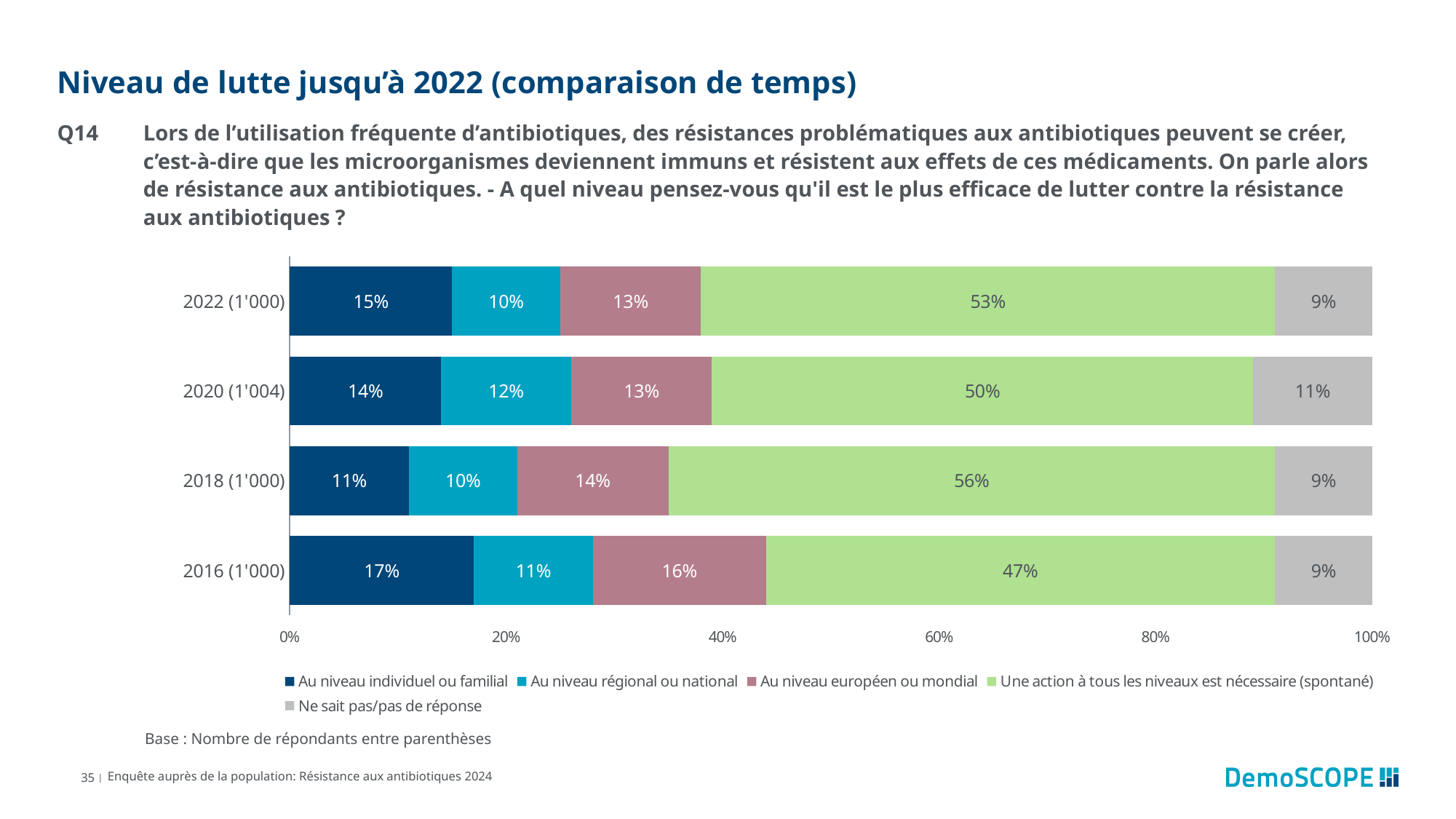
What is the value for 'Ne sait pas/pas de réponse' in 2020 (1'004)? 11% What kind of chart is shown on the slide? Stacked bar chart Does the share for 'Au niveau européen ou mondial' rise or fall from 2016 to 2022? Fall In which year is the share for 'Une action à tous les niveaux est nécessaire (spontané)' the highest? 2018 (1'000) What is the total of the stacked bar for 2022 (1'000)? 100% What is the difference between the 2018 and 2016 values for 'Une action à tous les niveaux est nécessaire (spontané)'? 9 percentage points What percentage of respondents in 2022 (1'000) chose 'Une action à tous les niveaux est nécessaire (spontané)'? 53% What is the value for 'Au niveau individuel ou familial' in 2016 (1'000)? 17% In which year is the share for 'Au niveau individuel ou familial' the lowest? 2018 (1'000) How many years (bars) are shown in the chart? 4 How many series does the legend list? 5 Which year has the larger value for 'Au niveau régional ou national', 2020 (1'004) or 2022 (1'000)? 2020 (1'004)